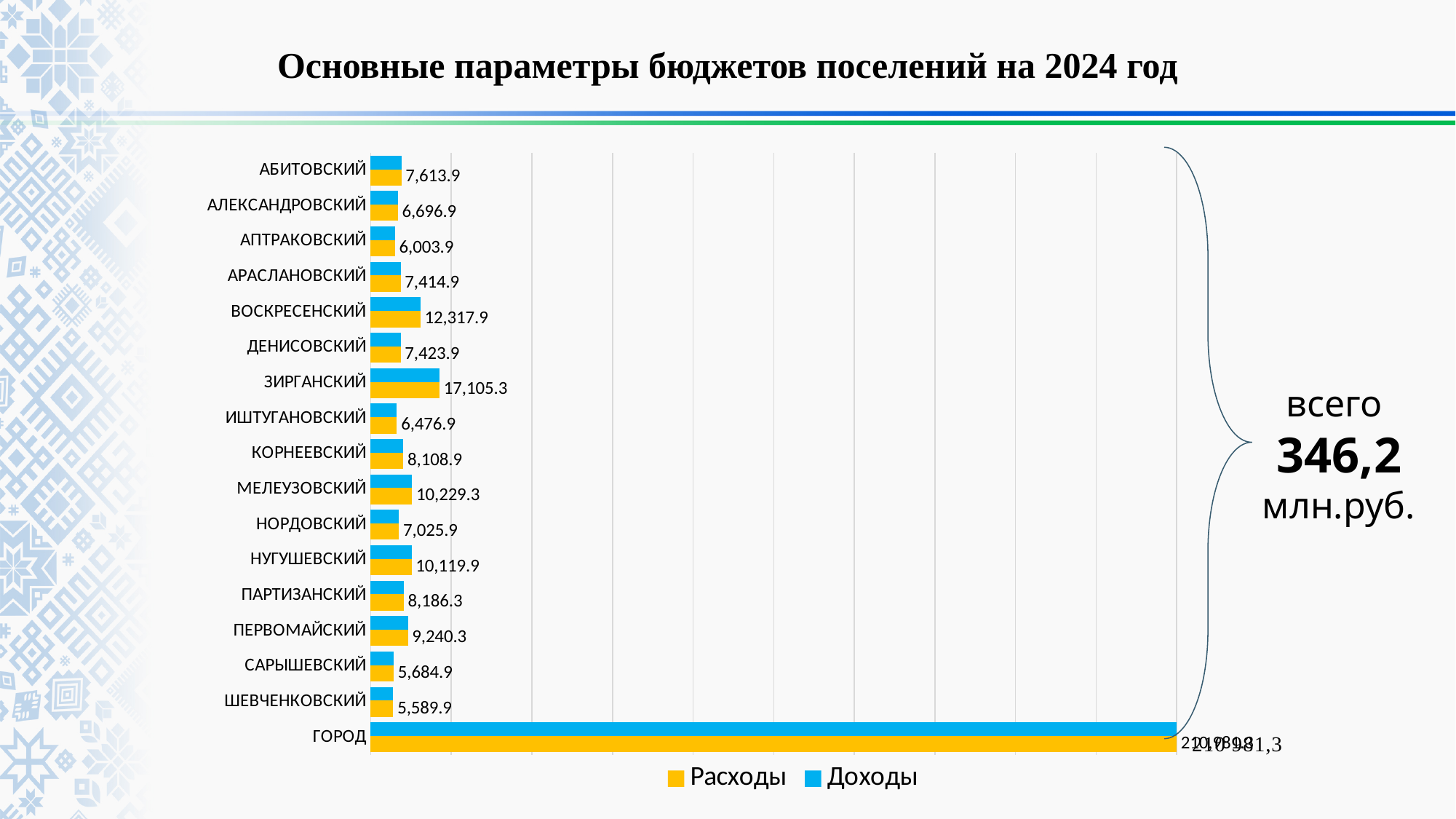
What is the labelled Расходы value for ЗИРГАНСКИЙ? 17,105.3 How many series does the legend list? 2 Among the settlements other than ГОРОД, which has the highest labelled Расходы value? ЗИРГАНСКИЙ What total amount is shown next to the bracket on the right of the chart? 346,2 млн.руб. What is the labelled Расходы value for ШЕВЧЕНКОВСКИЙ? 5,589.9 Which settlement has the lowest labelled Расходы value? ШЕВЧЕНКОВСКИЙ Which has the larger labelled Расходы value, ПЕРВОМАЙСКИЙ or КОРНЕЕВСКИЙ? ПЕРВОМАЙСКИЙ What is the difference between the labelled Расходы values for ЗИРГАНСКИЙ and ВОСКРЕСЕНСКИЙ? 4,787.4 How many categories (settlements including ГОРОД) are plotted on the chart? 17 What kind of chart is shown on the slide? bar chart What are the two series named in the legend? Расходы and Доходы What is the labelled Расходы value for ВОСКРЕСЕНСКИЙ? 12,317.9